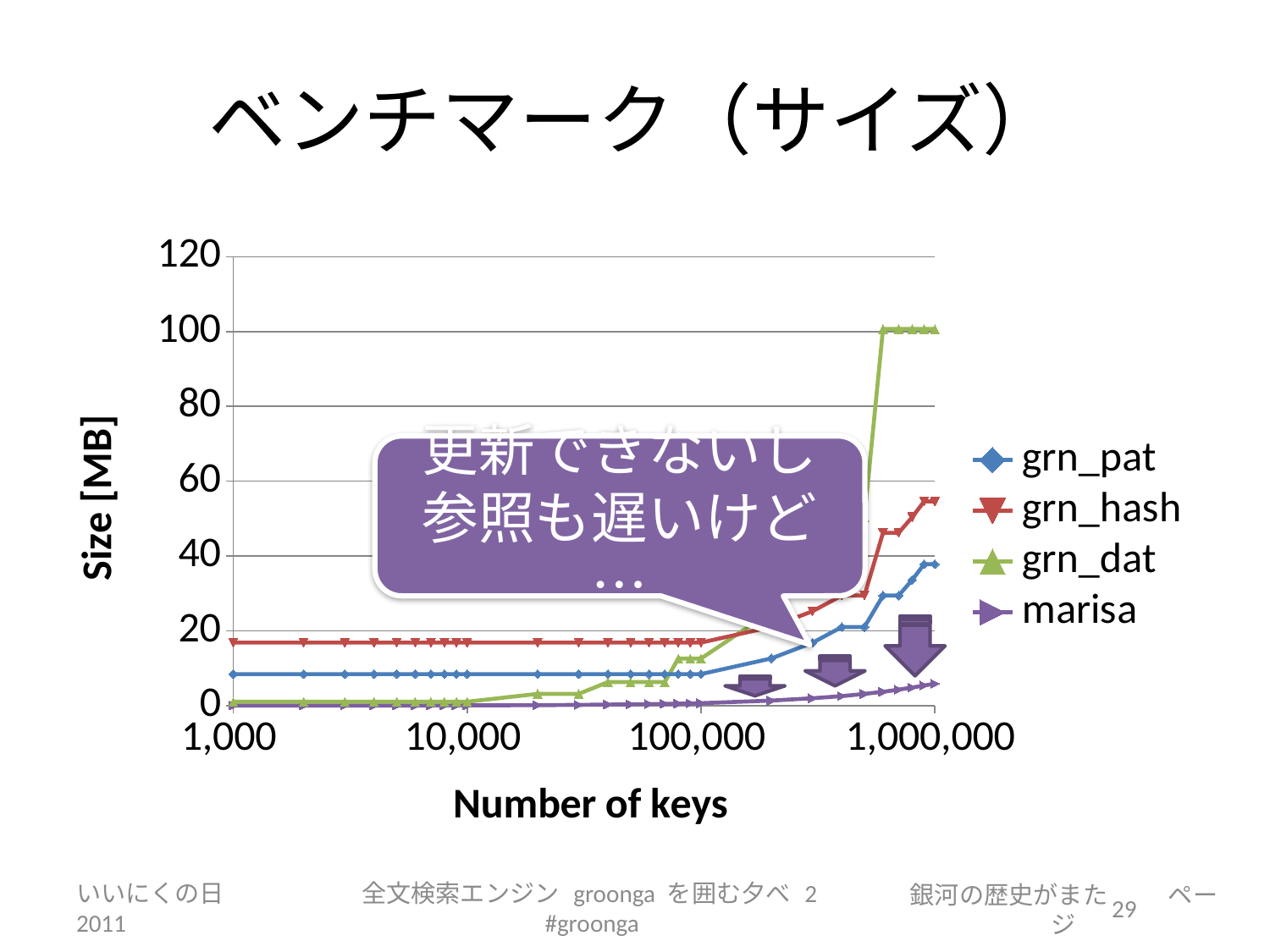
Is the value for marisa at 1,000,000 keys greater or less than 20? less Is the value for grn_hash at 1,000,000 keys greater or less than 40? greater Is the value for grn_dat at 1,000,000 keys greater or less than 80? greater At 1,000 keys, which is larger: grn_hash or grn_pat? grn_hash How many series does the legend list? 4 What is the title of the vertical axis? Size [MB] Which series has the largest size at 1,000,000 keys? grn_dat Does the size for grn_dat rise or fall as the number of keys increases? rise What kind of chart is shown on the slide? line chart Which series has the smallest size at 1,000,000 keys? marisa